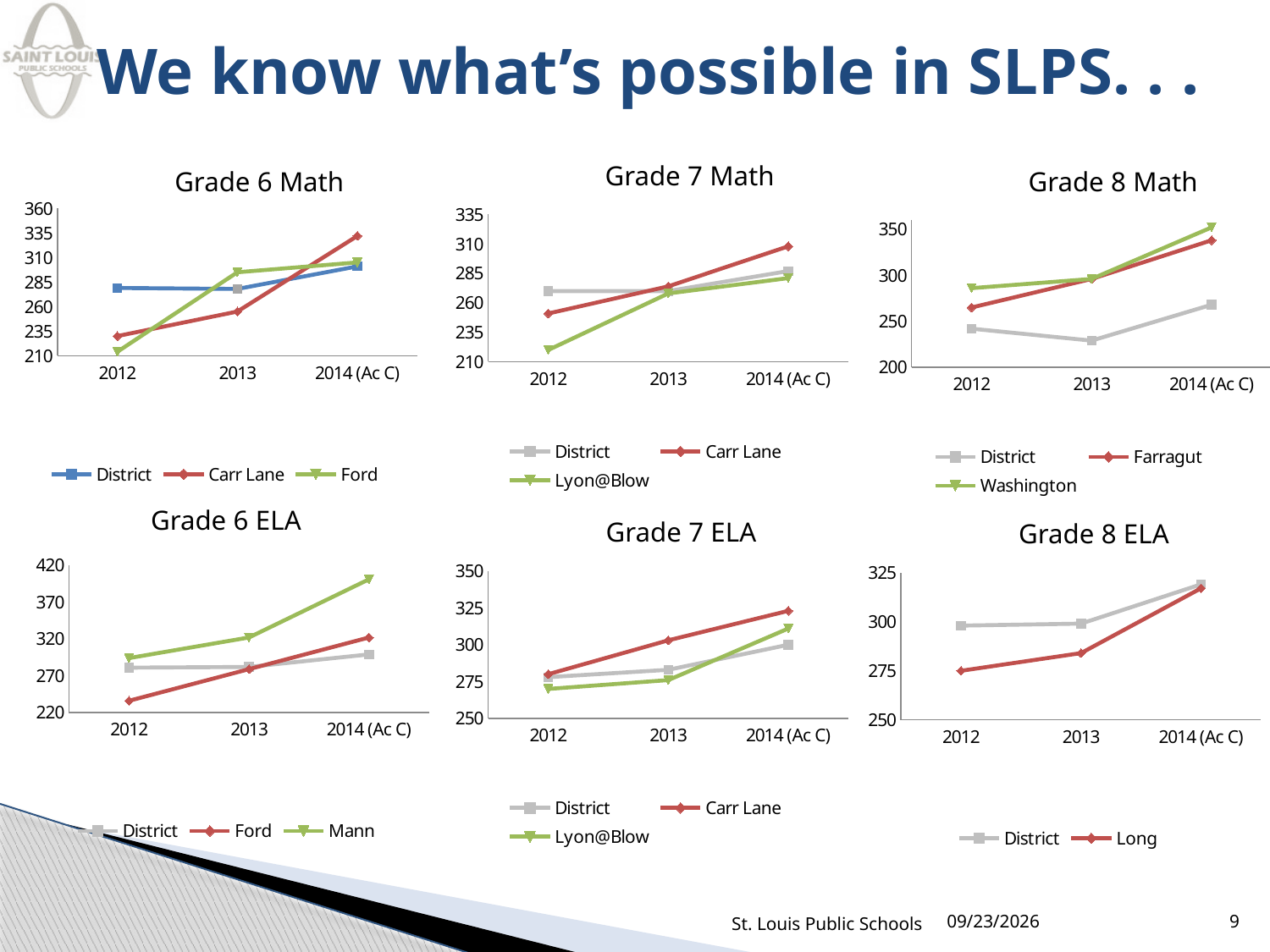
In the Grade 7 Math chart, is the value for Lyon@Blow in 2012 greater or less than 235? less How many points along the x axis does the Grade 6 ELA chart show? 3 In the Grade 7 ELA chart, is the value for Carr Lane in 2014 (Ac C) greater or less than 300? greater In the Grade 8 Math chart, which series is lowest in 2014 (Ac C)? District In the Grade 7 Math chart, does the Carr Lane line rise or fall from 2012 to 2014 (Ac C)? Rises In the Grade 8 Math chart, is the value for District in 2013 greater or less than 250? less In the Grade 8 ELA chart, which is larger in 2012, District or Long? District How many series does the legend of the Grade 7 Math chart list? 3 In the Grade 6 ELA chart, which series is highest in 2014 (Ac C)? Mann What kind of chart is the Grade 6 Math chart? Line chart In the Grade 6 Math chart, which series is highest in 2014 (Ac C)? Carr Lane How many series does the legend of the Grade 8 ELA chart list? 2